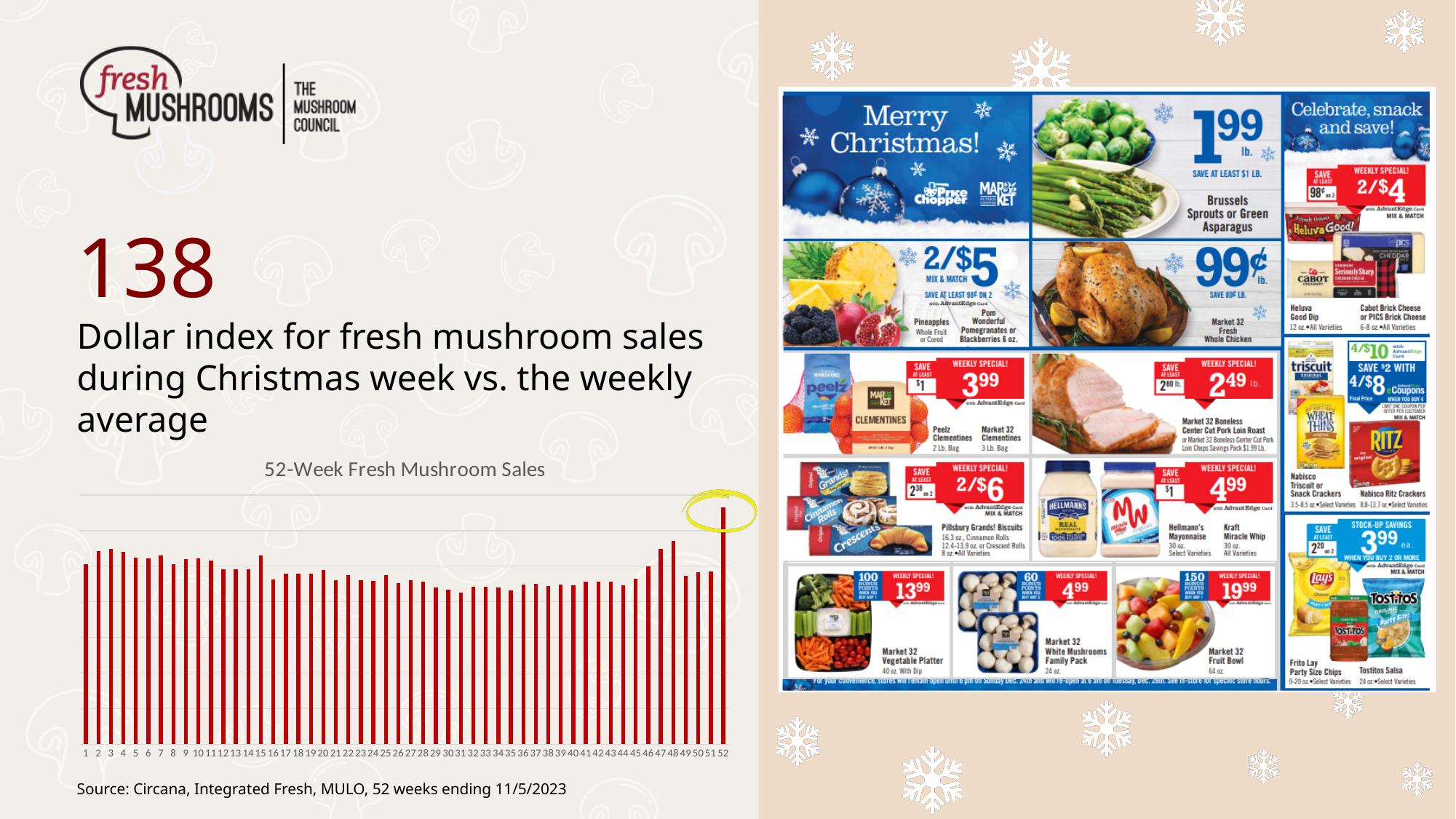
On the "52-Week Fresh Mushroom Sales" chart, is the bar for week 52 taller or shorter than the bar for week 1? taller On the "52-Week Fresh Mushroom Sales" chart, do the bars generally rise or fall from week 1 to week 30? fall On the "52-Week Fresh Mushroom Sales" chart, do the bars generally rise or fall from week 40 to week 48? rise What is the title of the bar chart on the slide? 52-Week Fresh Mushroom Sales On the "52-Week Fresh Mushroom Sales" chart, which is taller: the bar for week 48 or the bar for week 30? week 48 What kind of chart is the "52-Week Fresh Mushroom Sales" chart? bar chart On the "52-Week Fresh Mushroom Sales" chart, which bar is circled in yellow? Week 52 Which week has the highest bar on the "52-Week Fresh Mushroom Sales" chart? 52 How many weeks are plotted on the "52-Week Fresh Mushroom Sales" chart? 52 On the "52-Week Fresh Mushroom Sales" chart, which is taller: the bar for week 1 or the bar for week 31? week 1